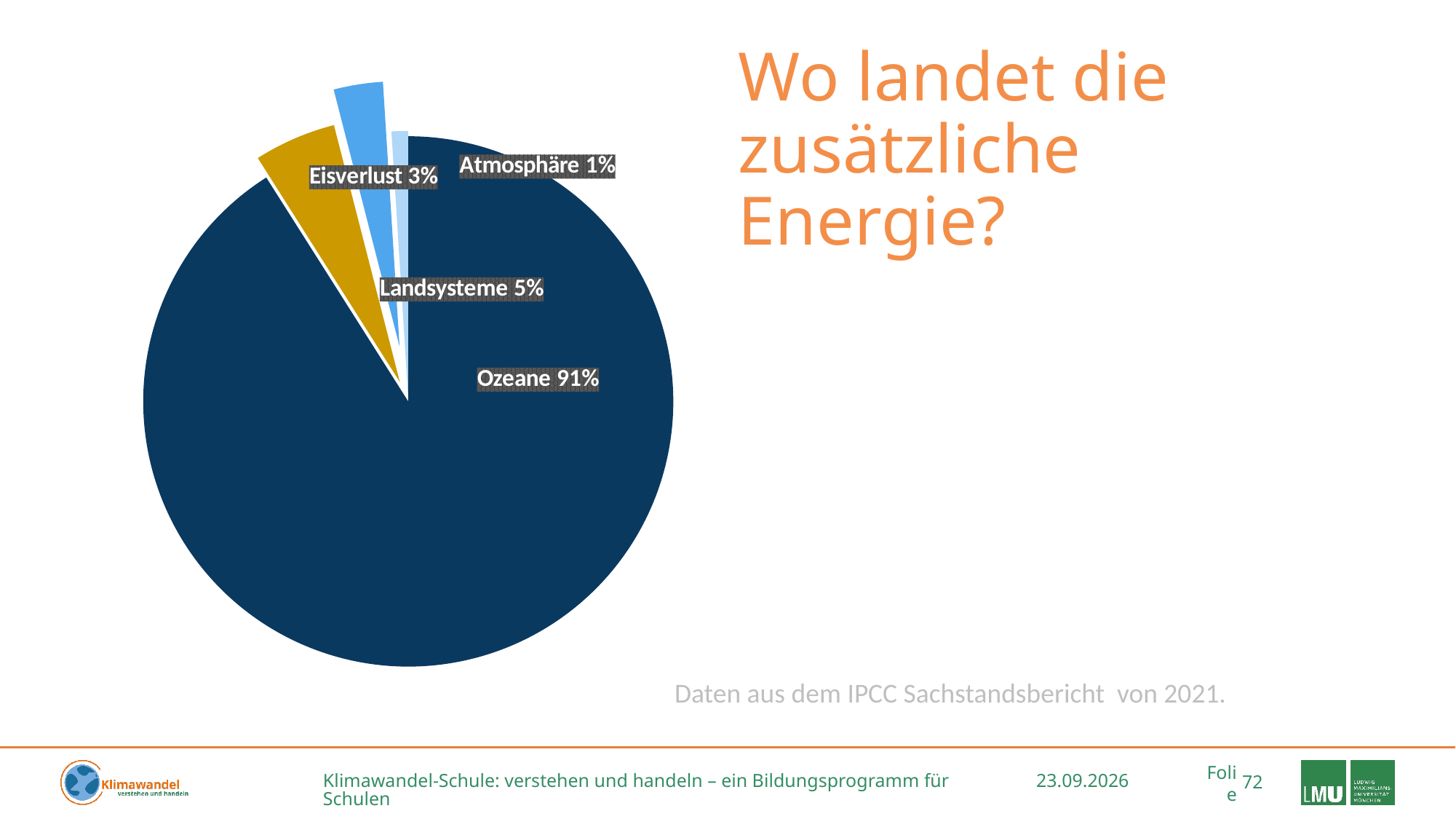
What is the difference in percentage points between Ozeane and Landsysteme? 86 Which category has the largest share of the pie? Ozeane What is the difference in percentage points between Landsysteme and Eisverlust? 2 What share of the additional energy goes to Eisverlust? 3% What kind of chart is shown on the slide? Pie chart Which is larger, the share for Eisverlust or the share for Atmosphäre? Eisverlust What share of the additional energy goes to Landsysteme? 5% How many slices does the pie chart have? 4 What share of the additional energy goes to Ozeane? 91% What share of the additional energy goes to Atmosphäre? 1% What colour is the Eisverlust slice? Gold/yellow Which category has the smallest share of the pie? Atmosphäre